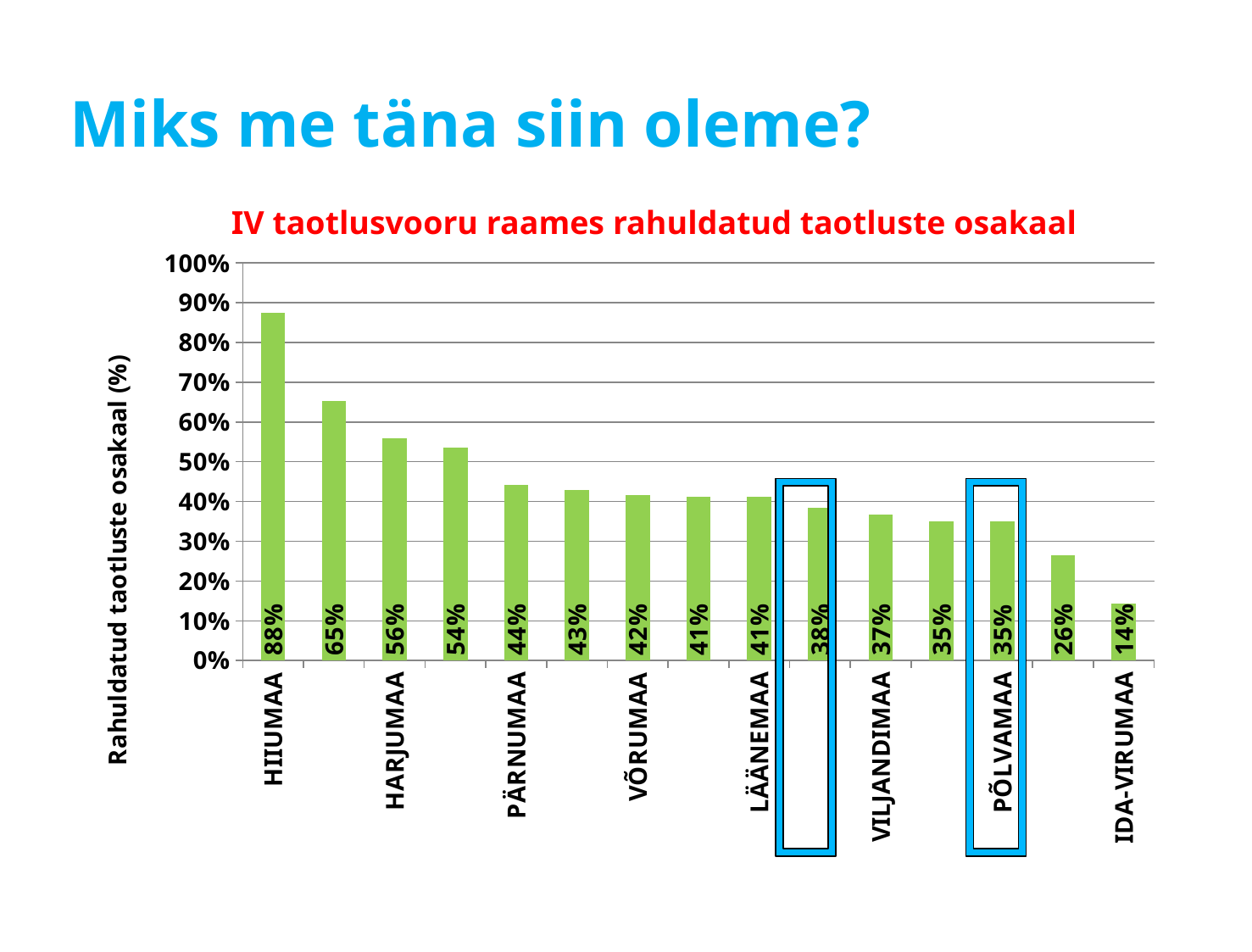
What is the difference between the values for HIIUMAA and IDA-VIRUMAA? 74 percentage points Which category has the lowest value? IDA-VIRUMAA What is the value for HARJUMAA? 56% What is the value for IDA-VIRUMAA? 14% What is the value for PÄRNUMAA? 44% Do the values rise or fall from left to right along the x axis? Fall Which is larger, the value for HARJUMAA or the value for PÕLVAMAA? HARJUMAA What is the value for HIIUMAA? 88% How many bars are plotted in the chart? 15 Which category has the highest value? HIIUMAA What kind of chart is shown on the slide? Bar chart What is the value for VILJANDIMAA? 37%